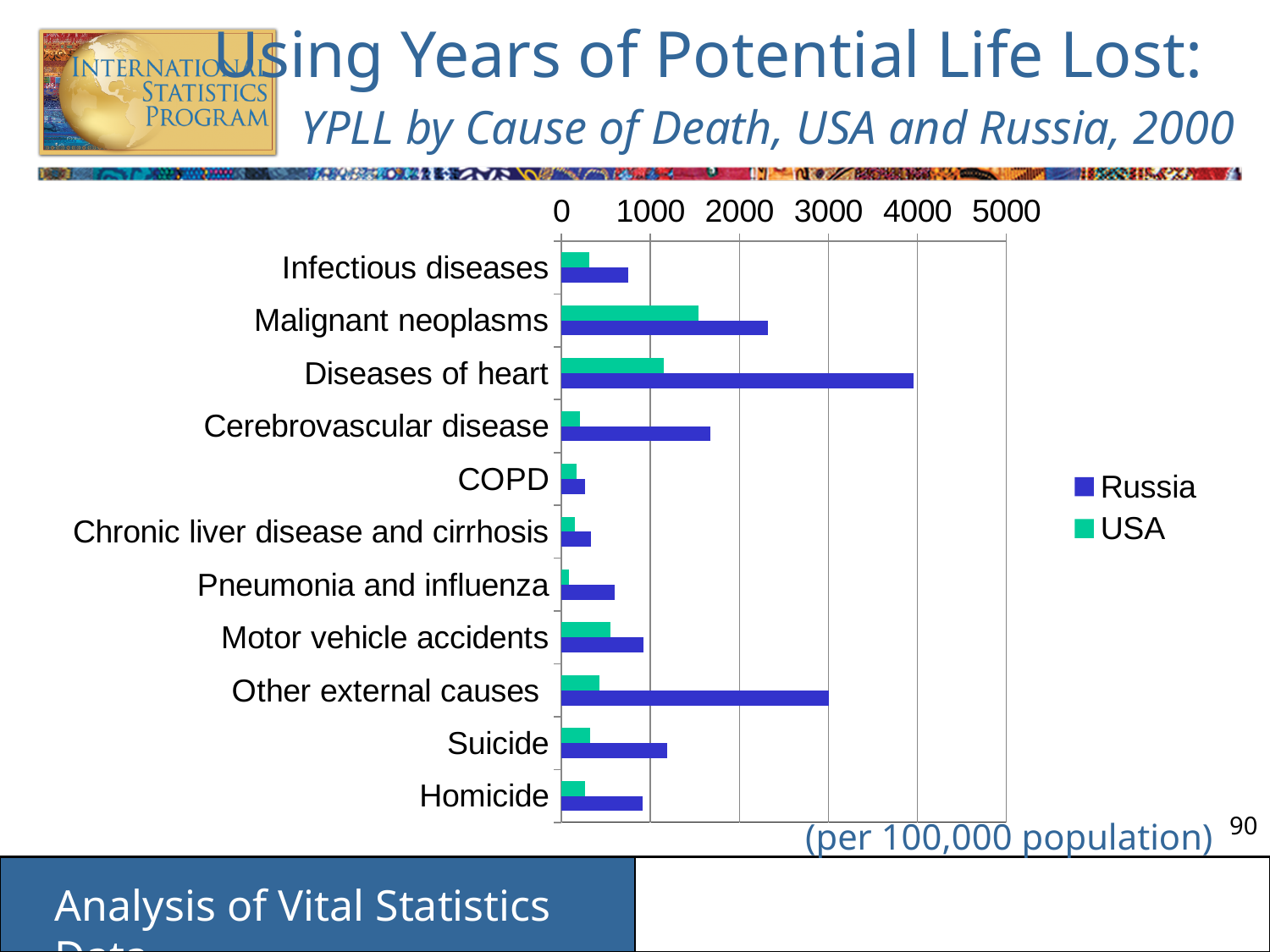
Which cause of death has the highest YPLL value for the USA? Malignant neoplasms For Russia, which is larger: the value for Malignant neoplasms or the value for Other external causes? Other external causes Is the Russia value for Infectious diseases greater or less than 1000? less What kind of chart is shown on the slide? Bar chart For Diseases of heart, which country has the larger YPLL value, Russia or the USA? Russia Is the USA value for Diseases of heart greater or less than 1000? greater How many causes of death are shown on the chart? 11 Which series is shown in blue in the legend? Russia Is the Russia value for Diseases of heart greater or less than 3000? greater How many series does the legend list? 2 Which cause of death has the highest YPLL value for Russia? Diseases of heart Which cause of death has the lowest YPLL value for the USA? Pneumonia and influenza